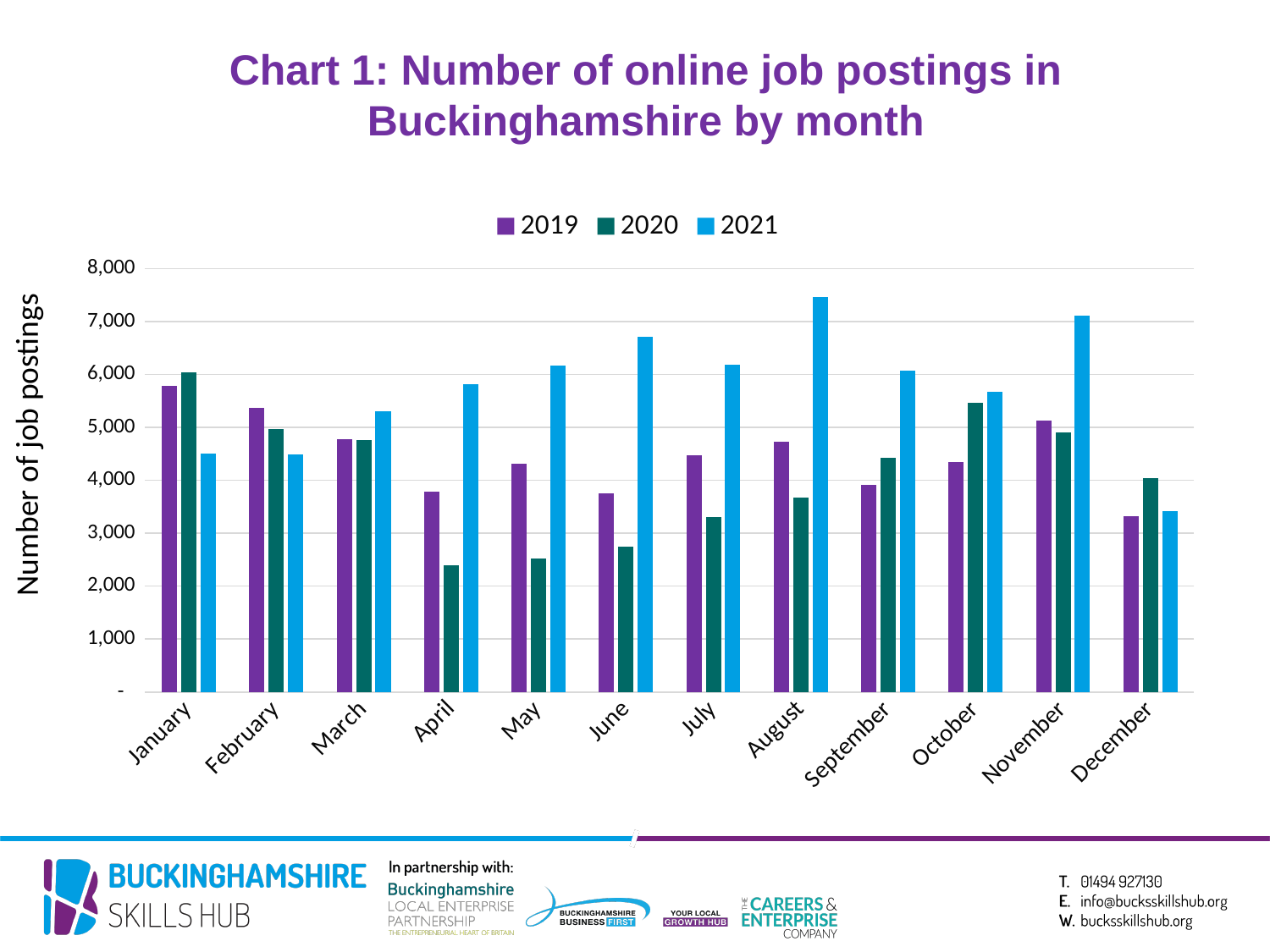
In June, which year has more job postings, 2019 or 2021? 2021 Which month has the highest number of job postings for 2021? August Which month has the lowest number of job postings for 2020? April What kind of chart is shown on the slide? bar chart Which month has the highest number of job postings for 2019? January How many months are shown on the x axis? 12 In January, which year has more job postings, 2020 or 2021? 2020 What is the title of the y axis? Number of job postings Is the value for April 2020 greater or less than 3,000? less What are the entries in the chart's legend? 2019, 2020, 2021 Is the value for August 2021 greater or less than 7,000? greater How many series does the legend list? 3